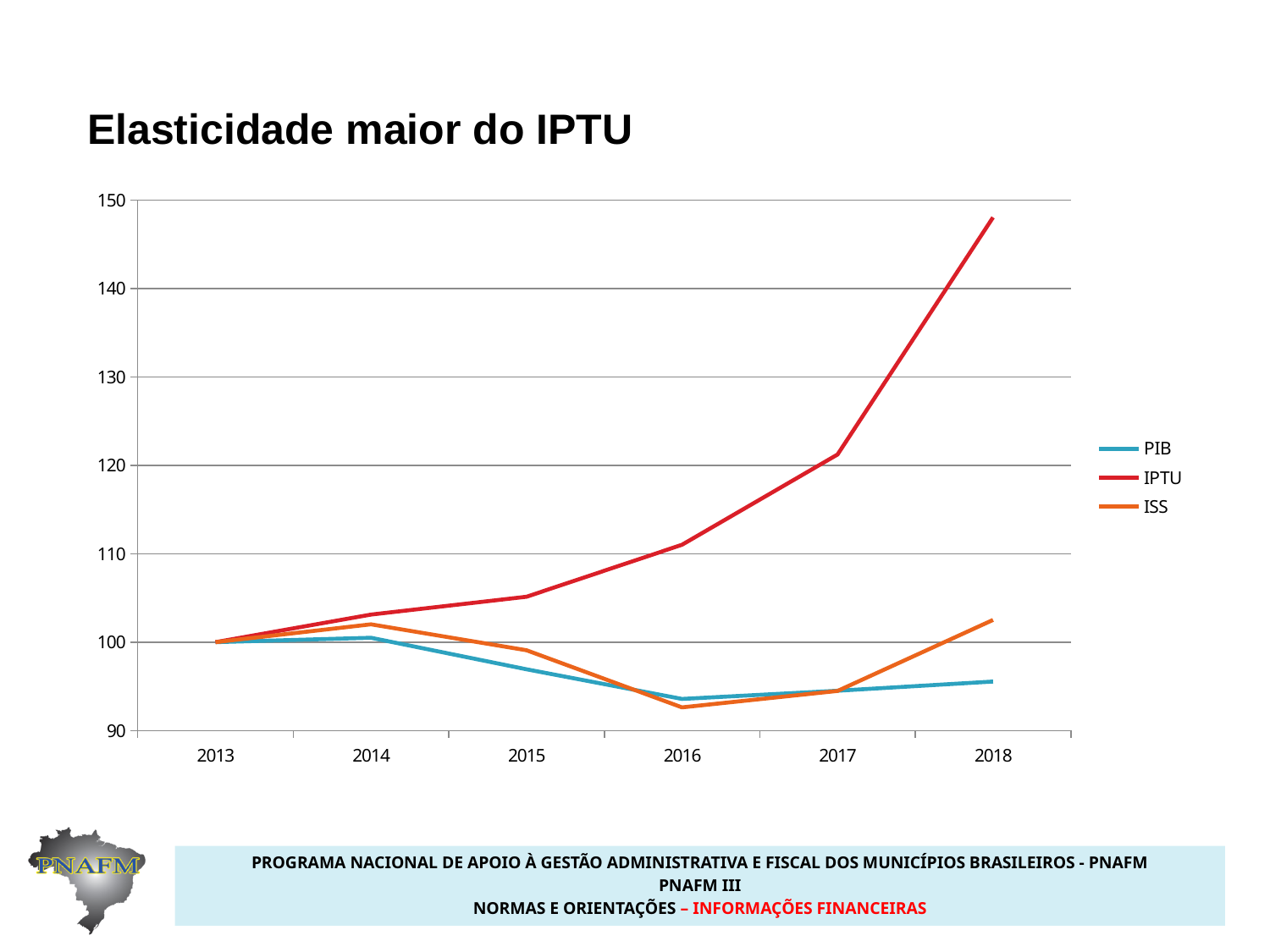
Is the value for IPTU in 2018 greater or less than 140? greater How many series does the legend list? 3 Is the value for PIB in 2016 greater or less than 100? less Does the IPTU line rise or fall from 2013 to 2018? rises Which series has the highest value in 2018? IPTU What kind of chart is shown on the slide? line chart How many years are shown on the x axis? 6 Is the value for ISS in 2018 greater or less than 100? greater Which is larger in 2017, the value for IPTU or the value for ISS? IPTU Which series has the lowest value in 2018? PIB What is the title of the slide above the chart? Elasticidade maior do IPTU